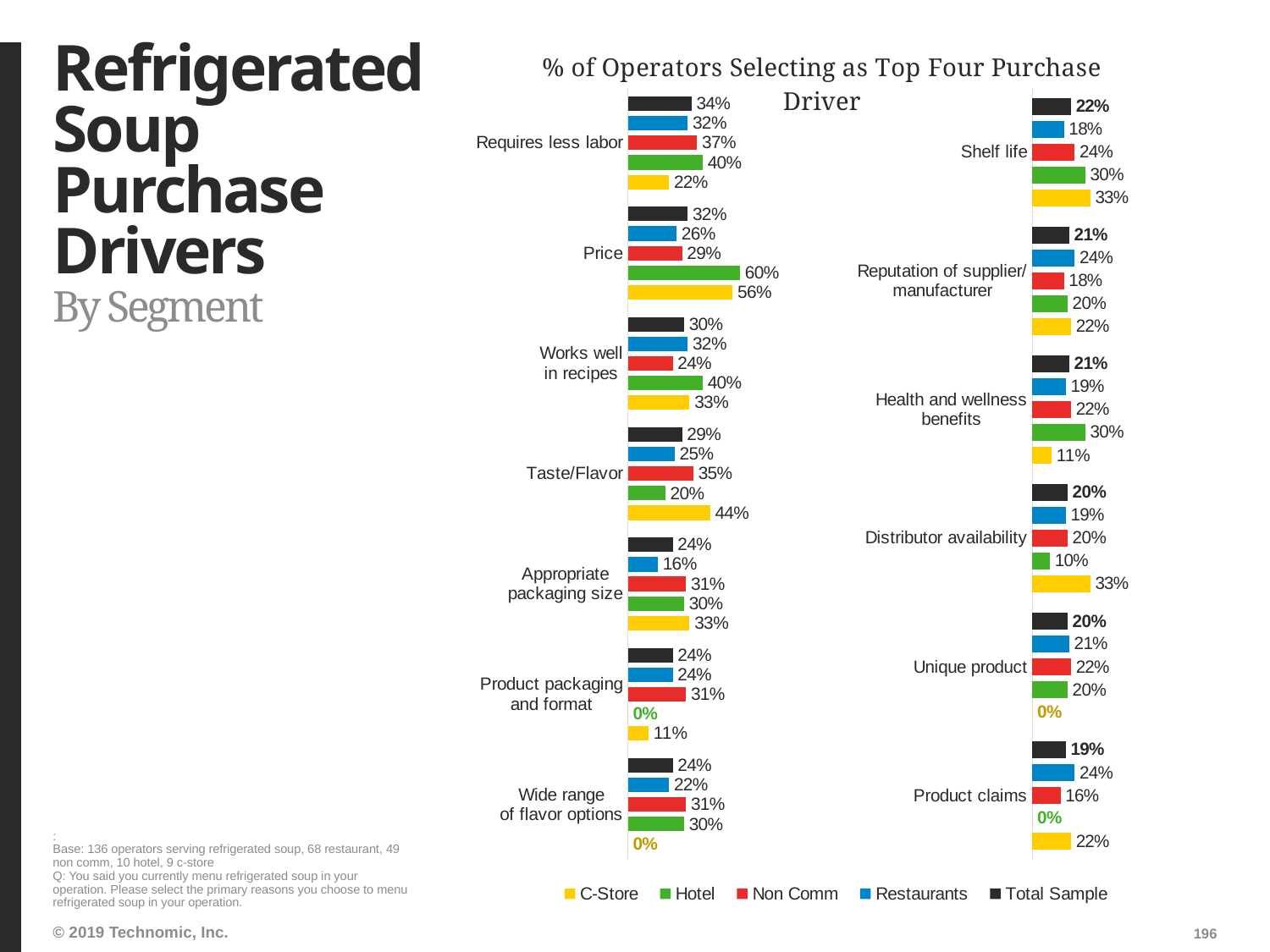
What is the difference between the Hotel and Restaurants values for 'Price'? 34 percentage points What percentage of Non Comm operators selected 'Shelf life' as a top four purchase driver? 24% Which segment has the highest value for 'Price'? Hotel Which colour represents the C-Store segment in the chart? Yellow Which segment has the lowest value for 'Distributor availability'? Hotel How many purchase drivers (categories) are shown in the chart? 13 Which is larger for 'Health and wellness benefits': the Hotel value or the C-Store value? Hotel What percentage of Hotel operators selected 'Price' as a top four purchase driver? 60% How many segments (series) does the legend list? 5 What percentage of the Total Sample selected 'Requires less labor' as a top four purchase driver? 34% What percentage of C-Store operators selected 'Taste/Flavor' as a top four purchase driver? 44% What type of chart is shown on the slide? Bar chart